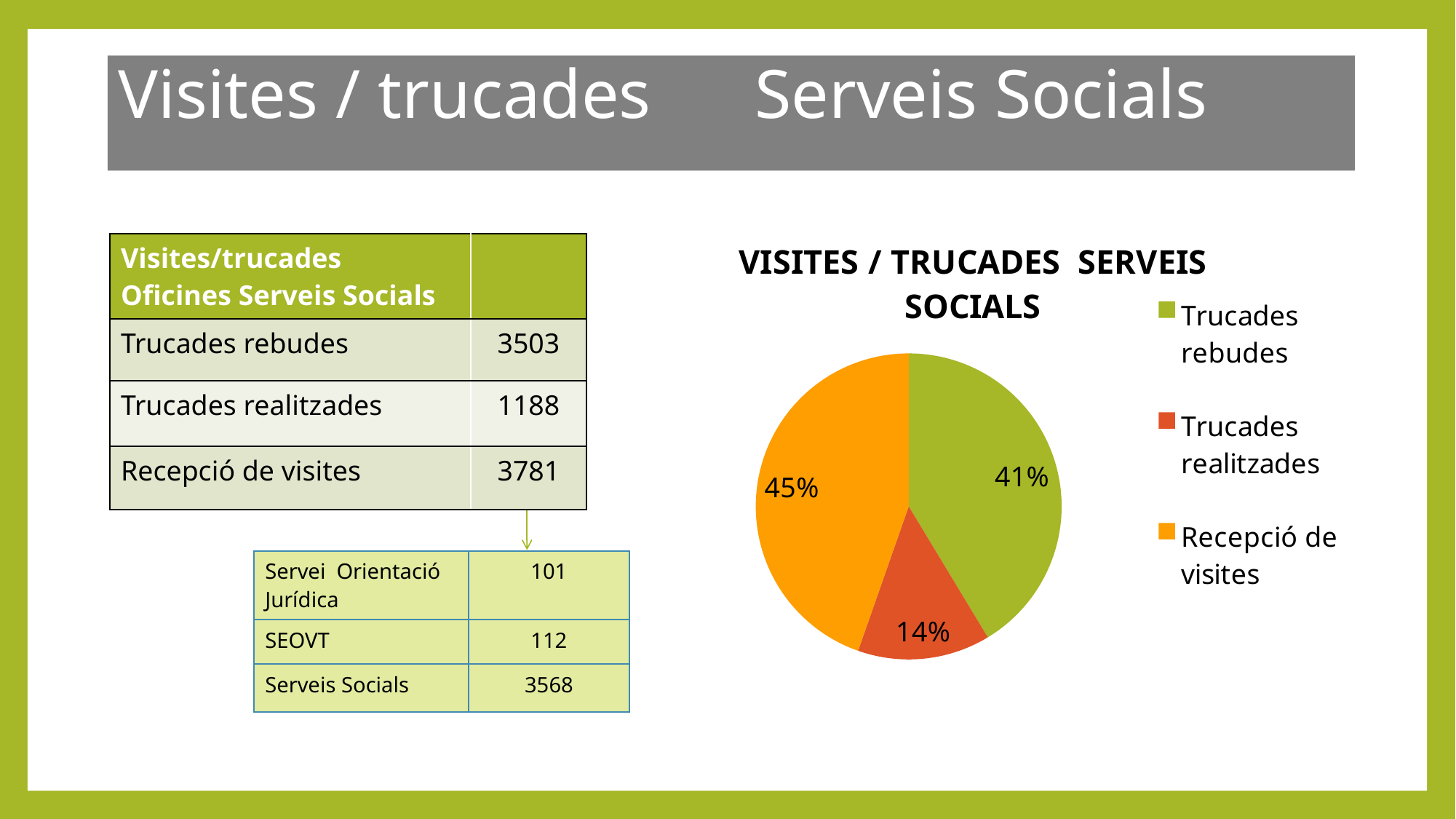
What percentage of the pie does Trucades rebudes represent? 41% Which slice of the pie chart is the smallest? Trucades realitzades What is the difference in percentage points between the Recepció de visites slice and the Trucades realitzades slice? 31 Which is larger in the pie chart, Trucades rebudes or Trucades realitzades? Trucades rebudes How many slices does the pie chart have? 3 What percentage of the pie does Recepció de visites represent? 45% Which colour represents Recepció de visites in the pie chart? orange Which slice of the pie chart is the largest? Recepció de visites How many entries does the legend of the pie chart list? 3 What is the title of the pie chart? VISITES / TRUCADES SERVEIS SOCIALS What percentage of the pie does Trucades realitzades represent? 14% What kind of chart is shown on the slide? pie chart